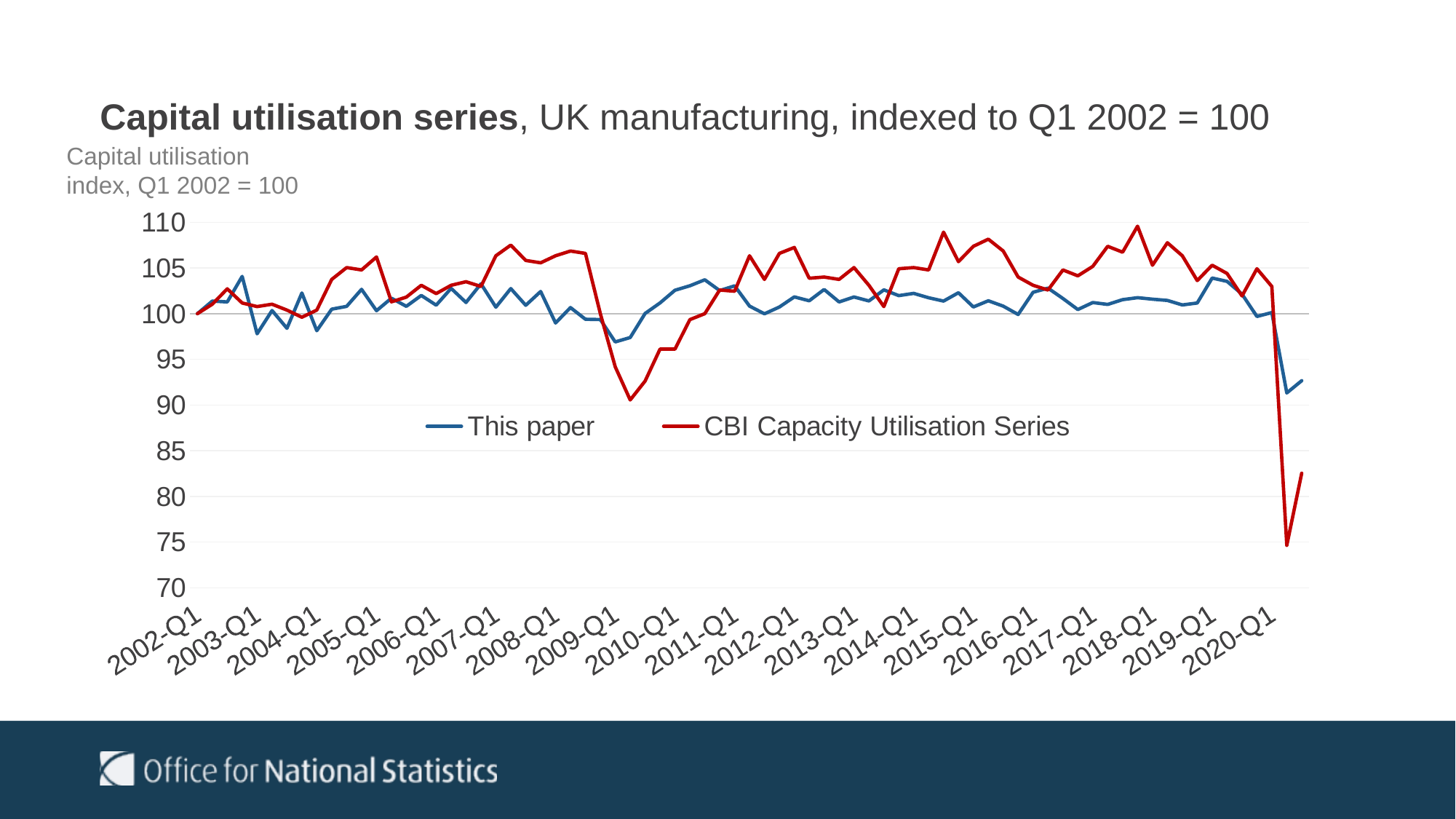
How many series does the legend list? 2 Is the peak value of the CBI Capacity Utilisation Series around 2018-Q1 greater or less than 105? greater What is the value of both series at 2002-Q1? 100 Around 2009-Q1, is the CBI Capacity Utilisation Series value greater or less than 95? less What kind of chart is shown on the slide? Line chart What are the two series named in the legend? This paper; CBI Capacity Utilisation Series Is the lowest value of the This paper series greater or less than 95? less Around 2009-Q1, which series has the lower value, This paper or CBI Capacity Utilisation Series? CBI Capacity Utilisation Series What is the y-axis label of the chart? Capital utilisation index, Q1 2002 = 100 Which series falls to the lowest value anywhere on the chart? CBI Capacity Utilisation Series Do both series rise or fall at the far right end of the chart, after 2020-Q1? fall